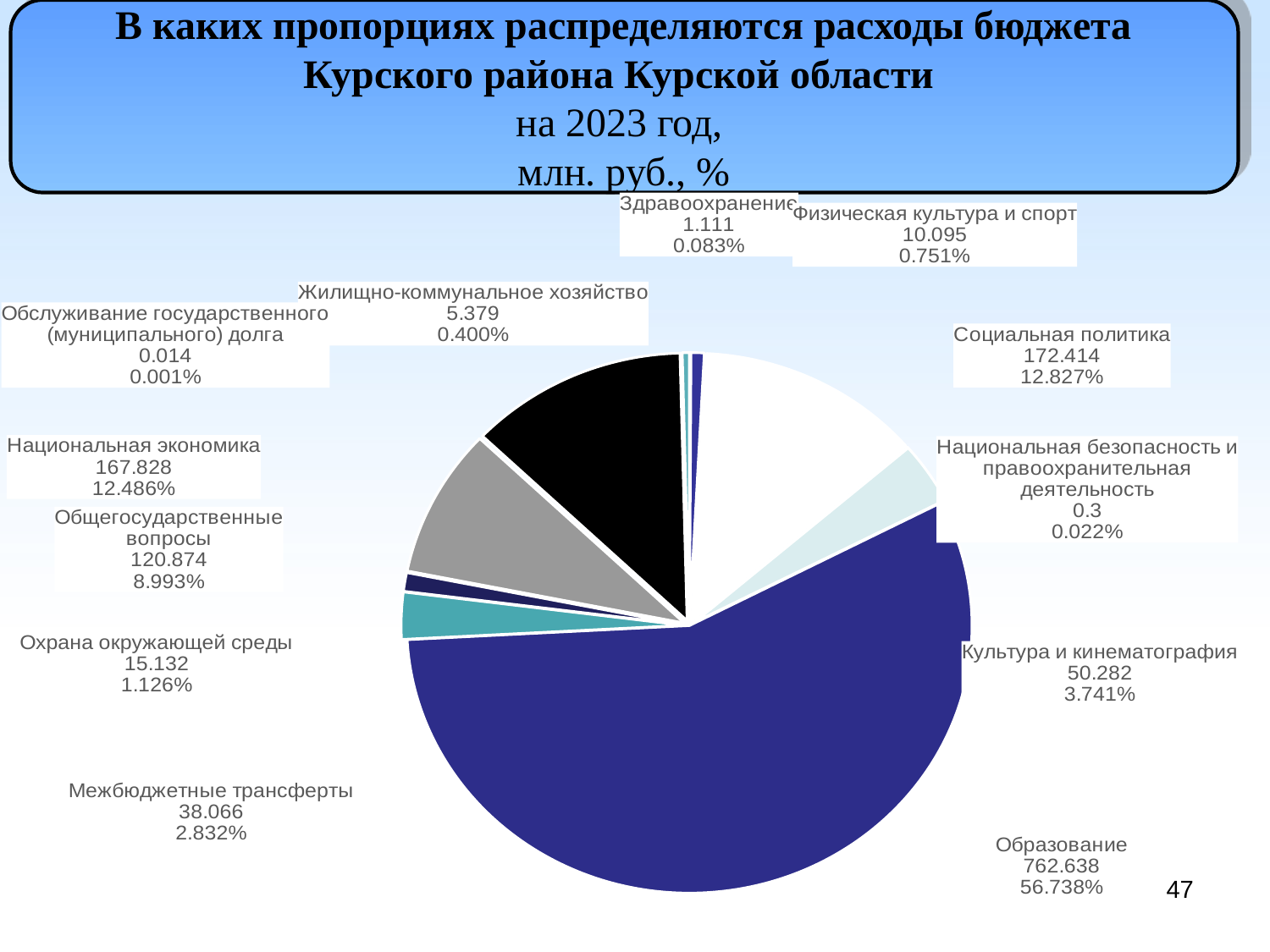
What is the value (in million rubles) for Образование? 762.638 What is the value for Социальная политика? 172.414 What share of the pie does Образование represent? 56.738% What is the difference between the values for Социальная политика and Национальная экономика? 4.586 What type of chart is shown on the slide? pie chart What year does the chart title say the budget expenditures are for? 2023 Which category has the largest value? Образование What percentage share does Национальная экономика have? 12.486% How many categories (slices) does the pie chart show? 12 What is the difference between the values for Общегосударственные вопросы and Культура и кинематография? 70.592 Which is larger: Межбюджетные трансферты or Охрана окружающей среды? Межбюджетные трансферты Which category has the smallest value? Обслуживание государственного (муниципального) долга